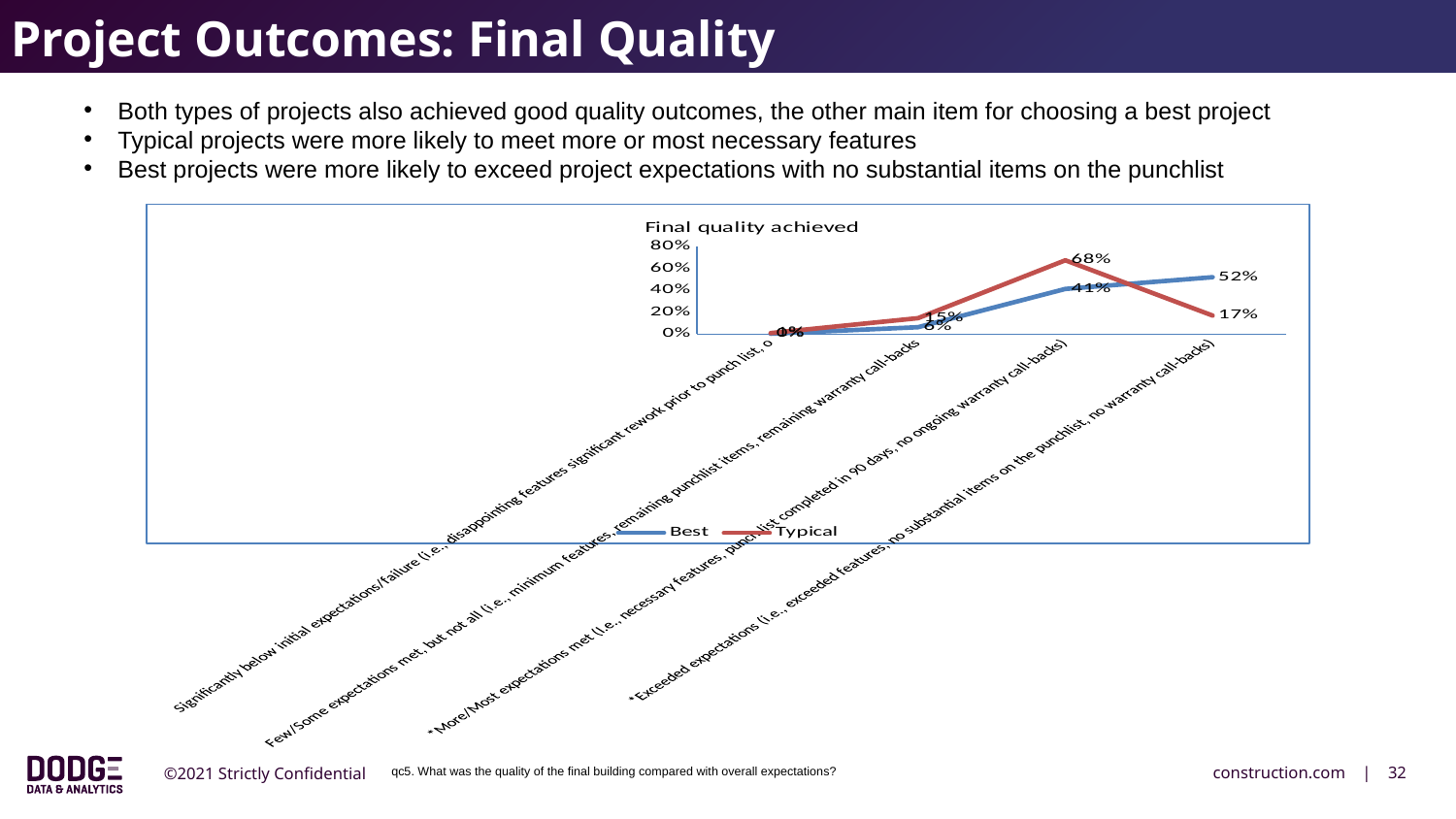
How many series does the chart's legend list? 2 In which category does the Best series reach its highest value? Exceeded expectations How many categories are plotted along the x axis of the chart? 4 What is the value for Typical projects in the 'Exceeded expectations' category? 17% In which category does the Typical series reach its highest value? More/Most expectations met What kind of chart is shown on the slide? Line chart What is the title of the chart? Final quality achieved What is the value for Best projects in the 'Exceeded expectations' category? 52% What is the value for Best projects in the 'More/Most expectations met' category? 41% What is the value for Typical projects in the 'More/Most expectations met' category? 68% What is the value for Typical projects in the 'Few/Some expectations met, but not all' category? 15% What is the difference between the Typical and Best values in the 'More/Most expectations met' category? 27 percentage points